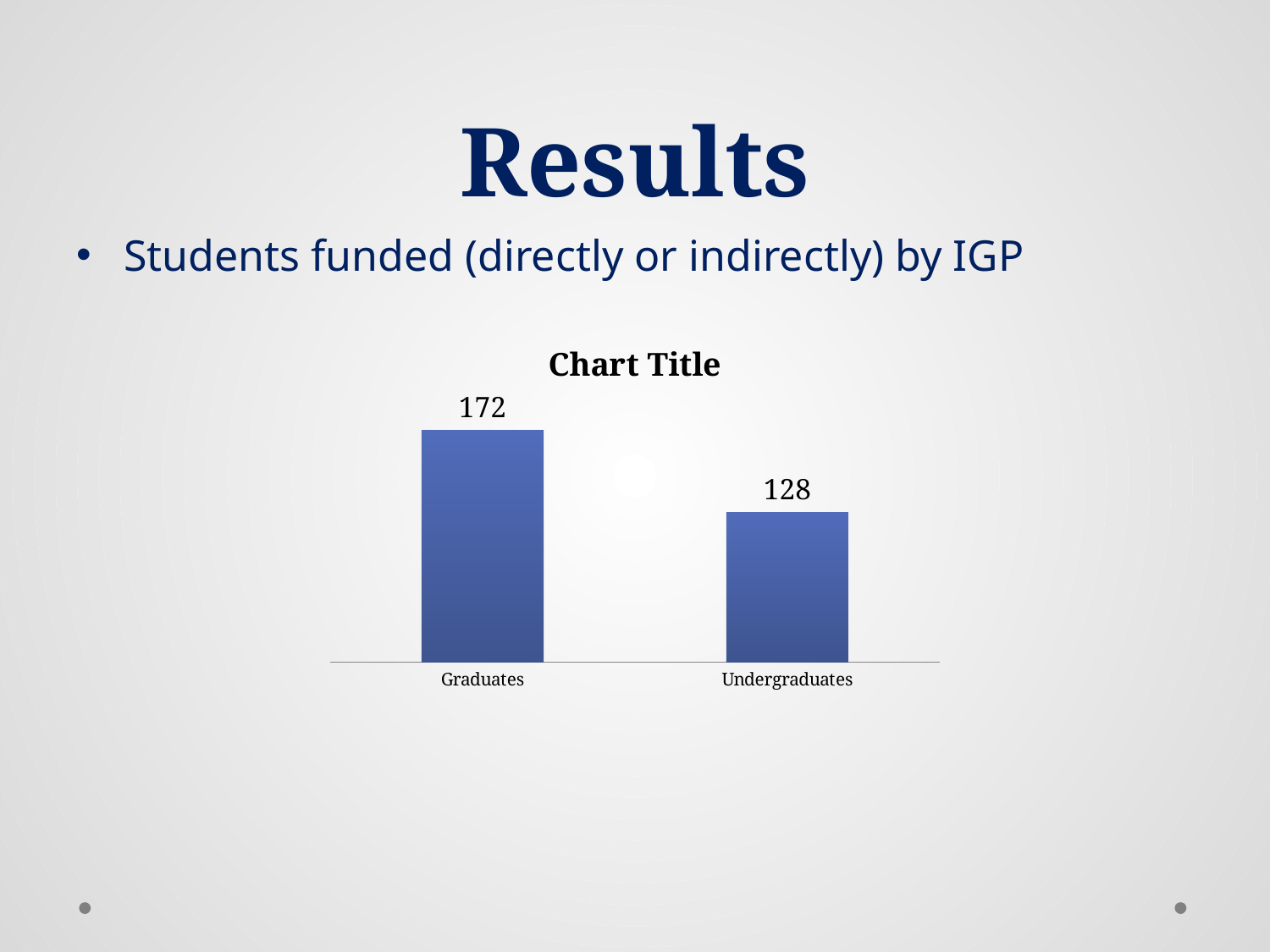
What is the difference between the values for Graduates and Undergraduates? 44 What colour are the bars in the chart? Blue Which is larger, the value for Graduates or the value for Undergraduates? Graduates How many categories are shown in the chart? 2 What is the value for Graduates? 172 What is the total of the values for Graduates and Undergraduates? 300 What kind of chart is shown on the slide? Bar chart Which category has the highest value? Graduates Which category has the lowest value? Undergraduates What is the value for Undergraduates? 128 What is the title of the chart? Chart Title